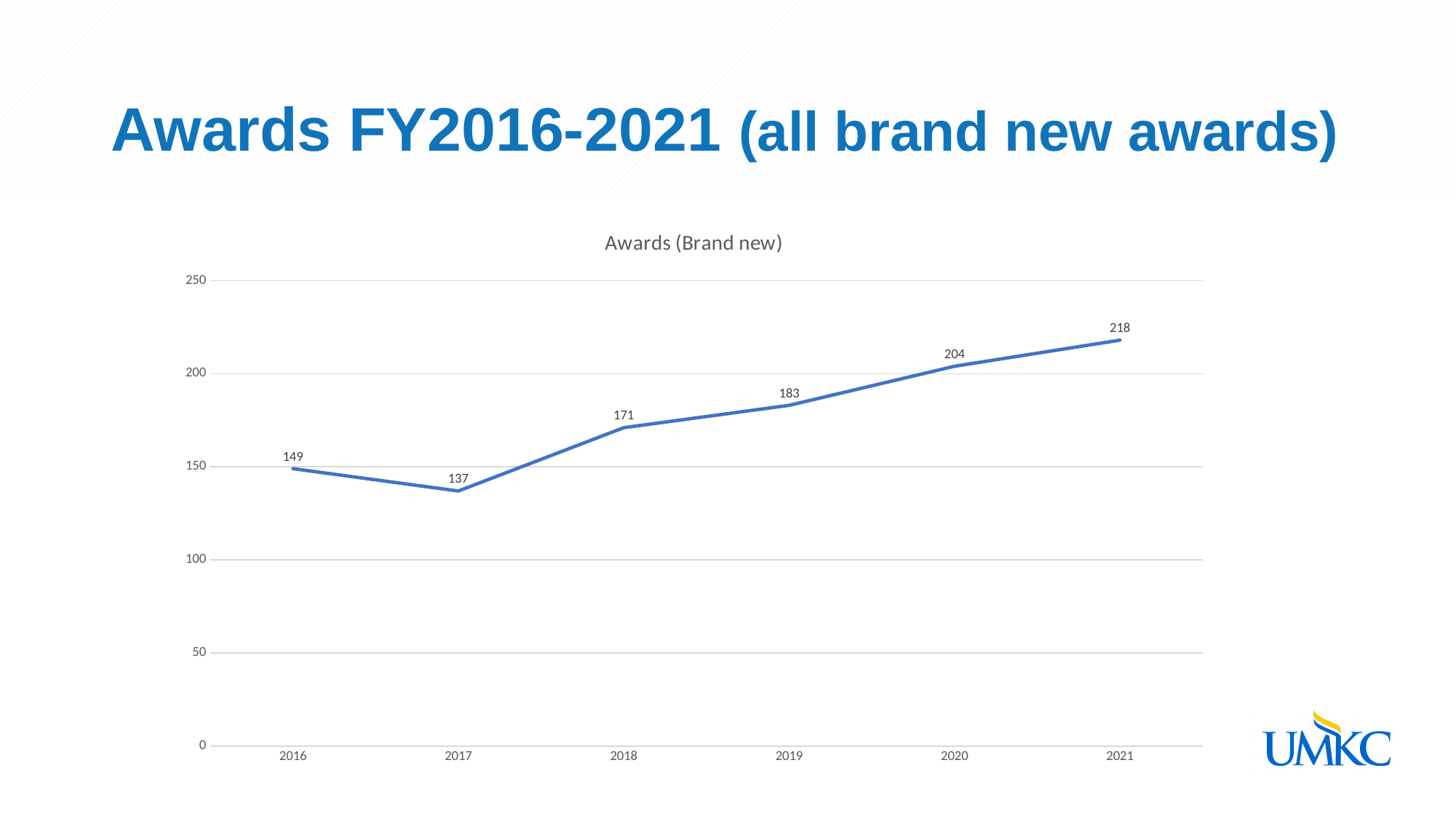
What kind of chart is shown? line chart What is the value for 2021? 218 Which year has the lowest value? 2017 Which is larger, the value for 2018 or the value for 2020? 2020 Which year has the highest value? 2021 What is the value for 2019? 183 What is the title of the chart? Awards (Brand new) How many years are plotted on the chart? 6 What is the value for 2017? 137 What is the value for 2016? 149 What is the difference between the values for 2018 and 2017? 34 What is the difference between the values for 2021 and 2016? 69